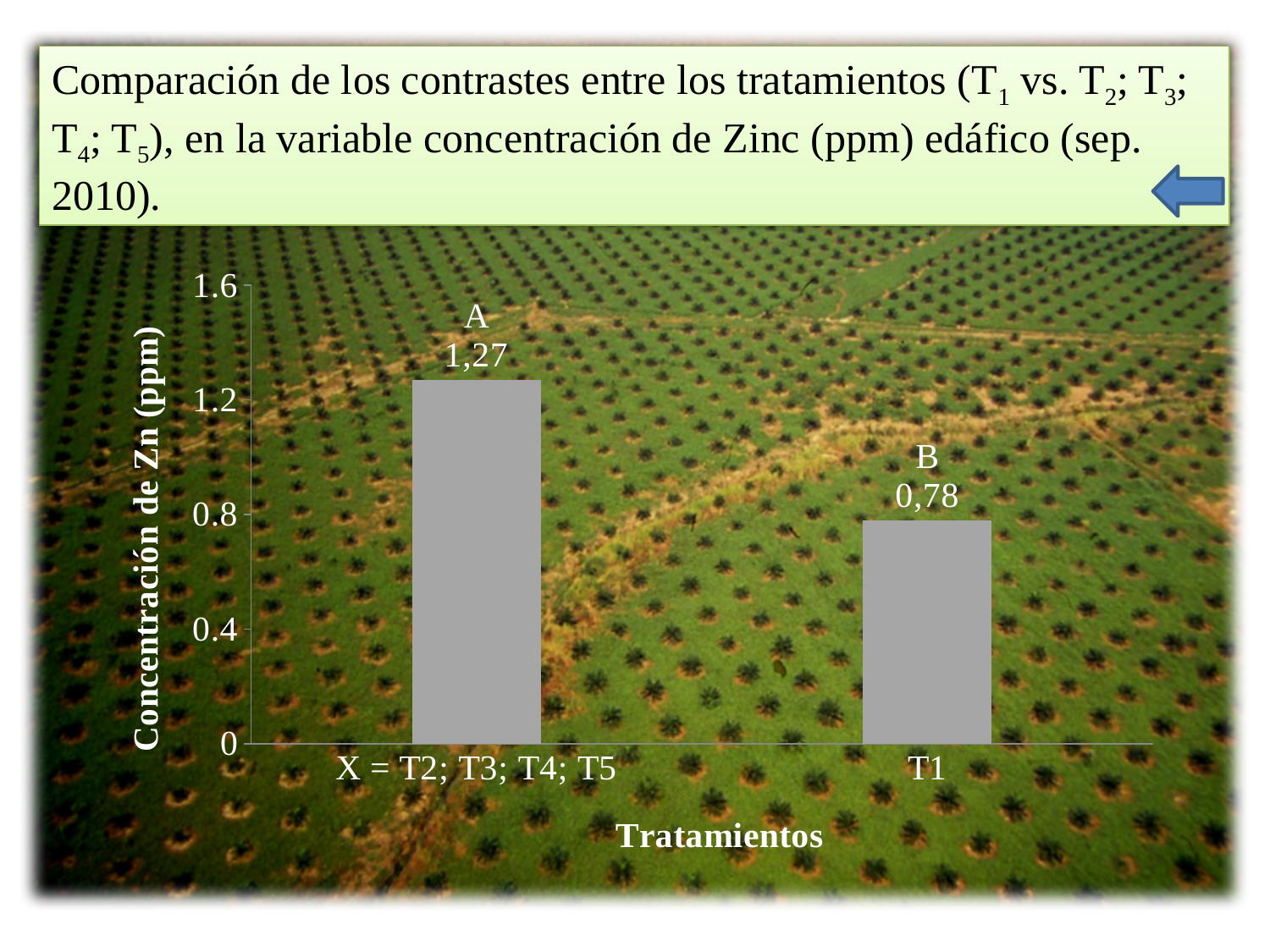
Is the value for T1 greater or less than 0.8? less What is the Zn concentration value shown for T1? 0,78 What is the difference between the Zn concentration for 'X = T2; T3; T4; T5' and for T1? 0,49 What is the label of the y axis? Concentración de Zn (ppm) What kind of chart is shown on the slide? bar chart Which has a larger Zn concentration, T1 or 'X = T2; T3; T4; T5'? X = T2; T3; T4; T5 Is the value for 'X = T2; T3; T4; T5' greater or less than 1.2? greater Which category has the highest Zn concentration? X = T2; T3; T4; T5 What is the Zn concentration value shown for the category 'X = T2; T3; T4; T5'? 1,27 How many categories are plotted on the chart? 2 What letter label appears above the T1 bar? B Which category has the lowest Zn concentration? T1